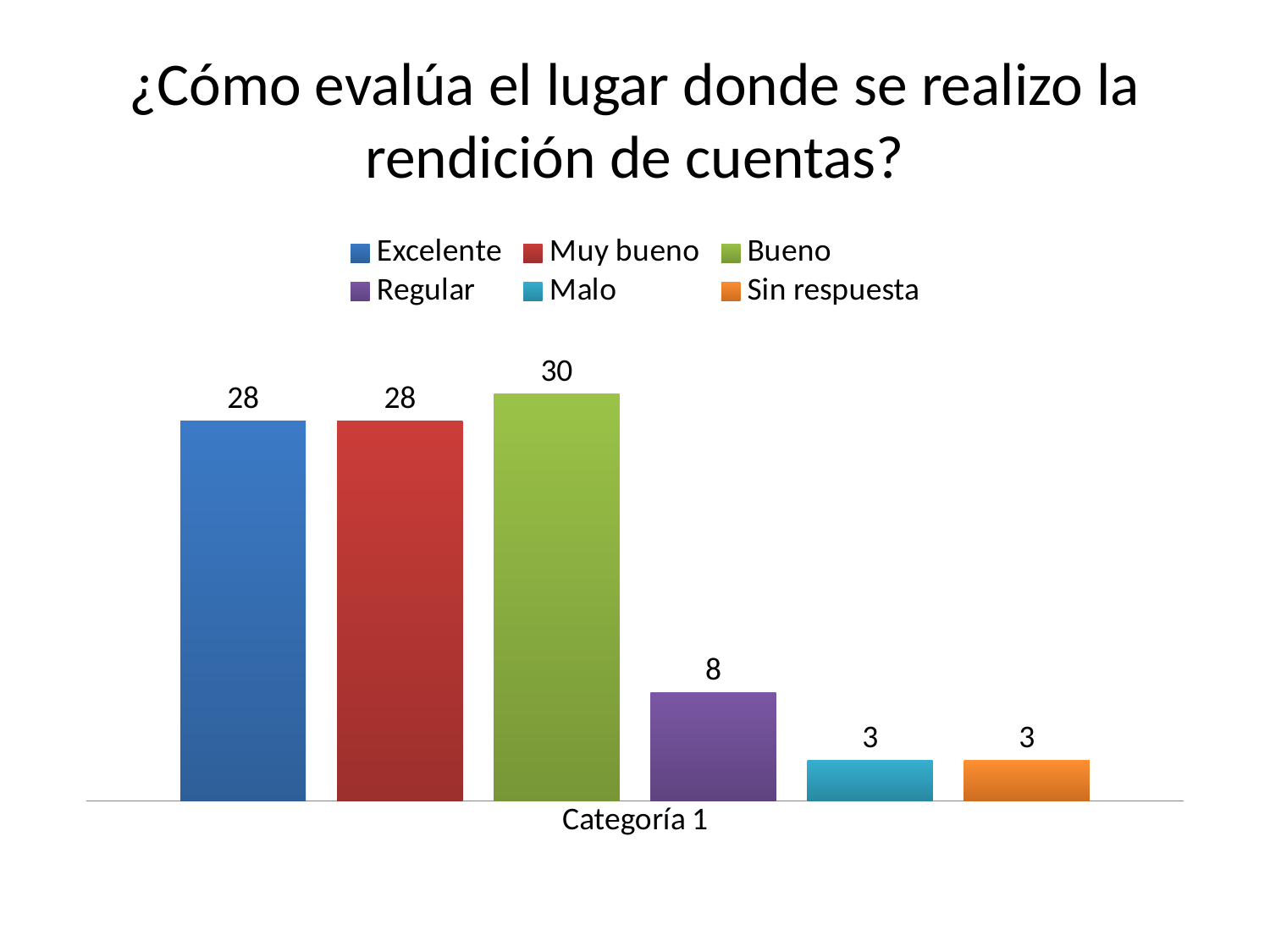
How many series does the legend list? 6 Which series has the highest value? Bueno What is the value for Malo? 3 What is the value for Excelente? 28 Which is larger, the value for Regular or the value for Malo? Regular What kind of chart is shown on the slide? Bar chart What is the difference between the values for Muy bueno and Sin respuesta? 25 What is the label on the x axis under the bars? Categoría 1 What is the value for Bueno? 30 What is the difference between the values for Bueno and Regular? 22 What colour is the bar for Sin respuesta? Orange What is the value for Regular? 8